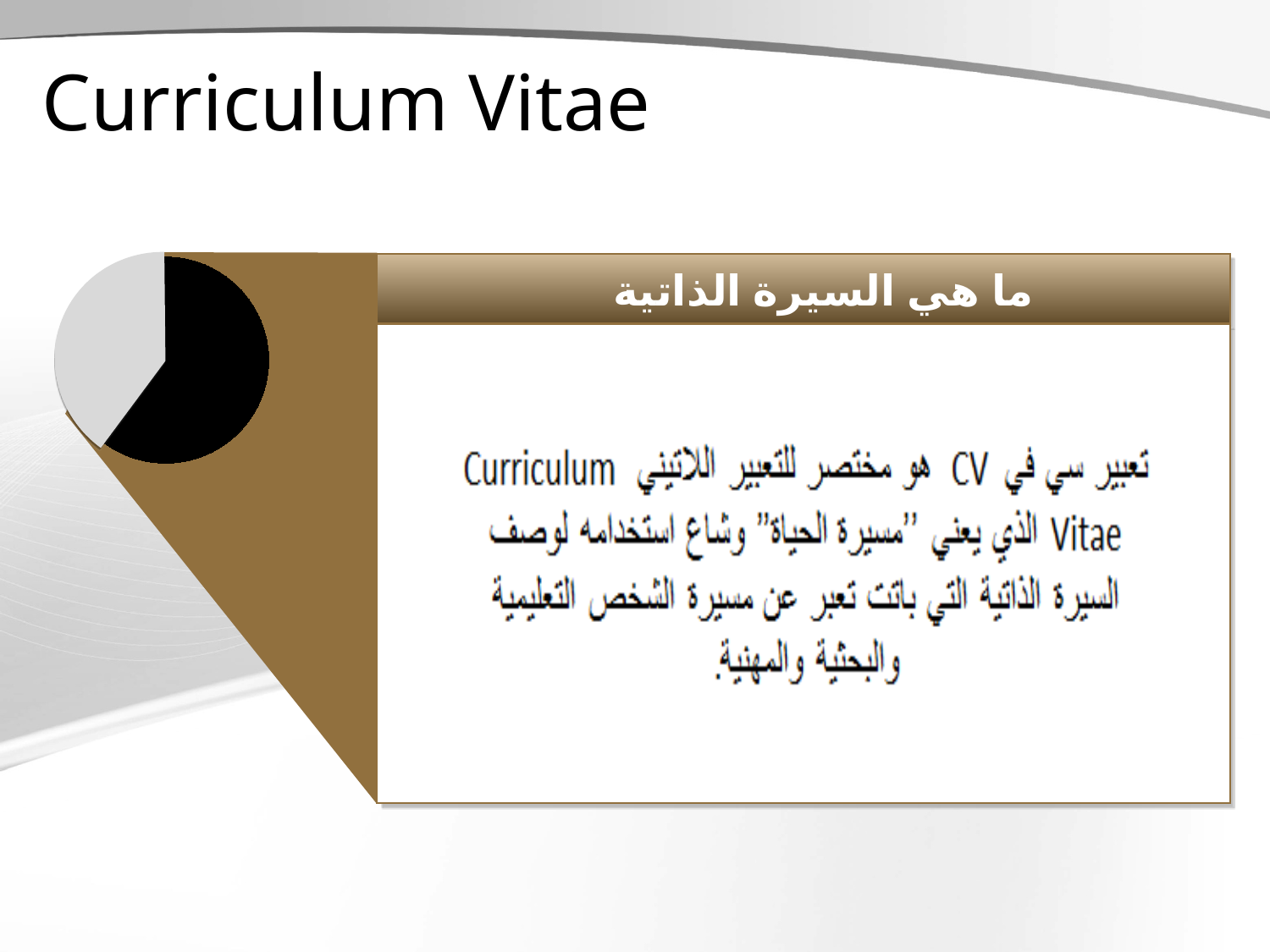
What two colours are used for the slices of the pie chart on the left of the slide? black and light gray In the pie chart on the left of the slide, which slice is larger, the black one or the light gray one? the black one What kind of chart is shown on the left side of the slide? pie chart Does the pie chart on the left of the slide show a legend? No